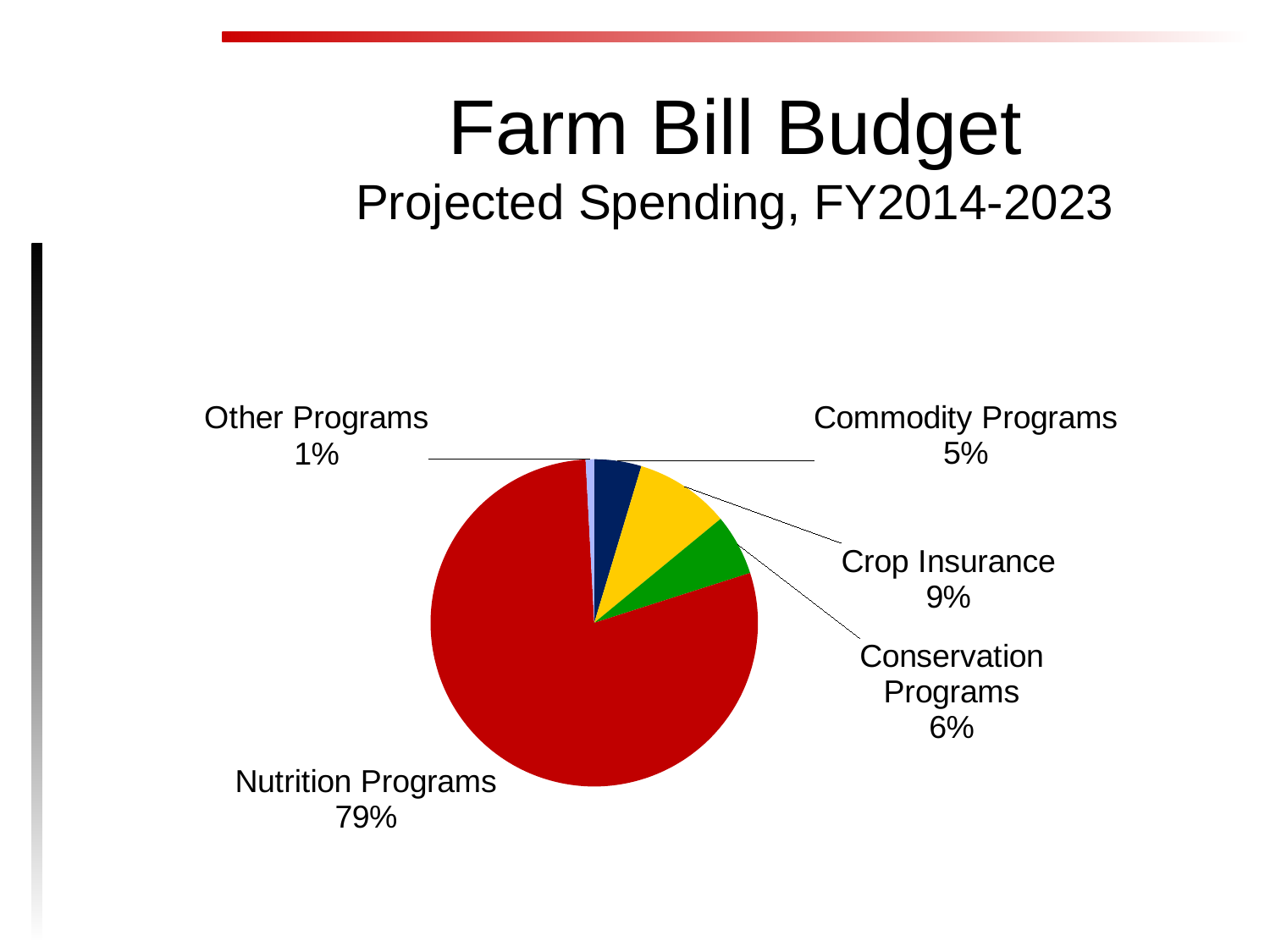
What is the difference in percentage points between Crop Insurance and Commodity Programs? 4 What share of projected spending goes to Conservation Programs? 6% How many categories are shown in the pie chart? 5 What share of projected spending goes to Other Programs? 1% Which is larger, the share for Crop Insurance or the share for Conservation Programs? Crop Insurance What share of projected spending goes to Crop Insurance? 9% Which category has the smallest share of the pie? Other Programs What kind of chart is shown on the slide? pie chart Which category has the largest share of the pie? Nutrition Programs What colour is the Nutrition Programs slice? red